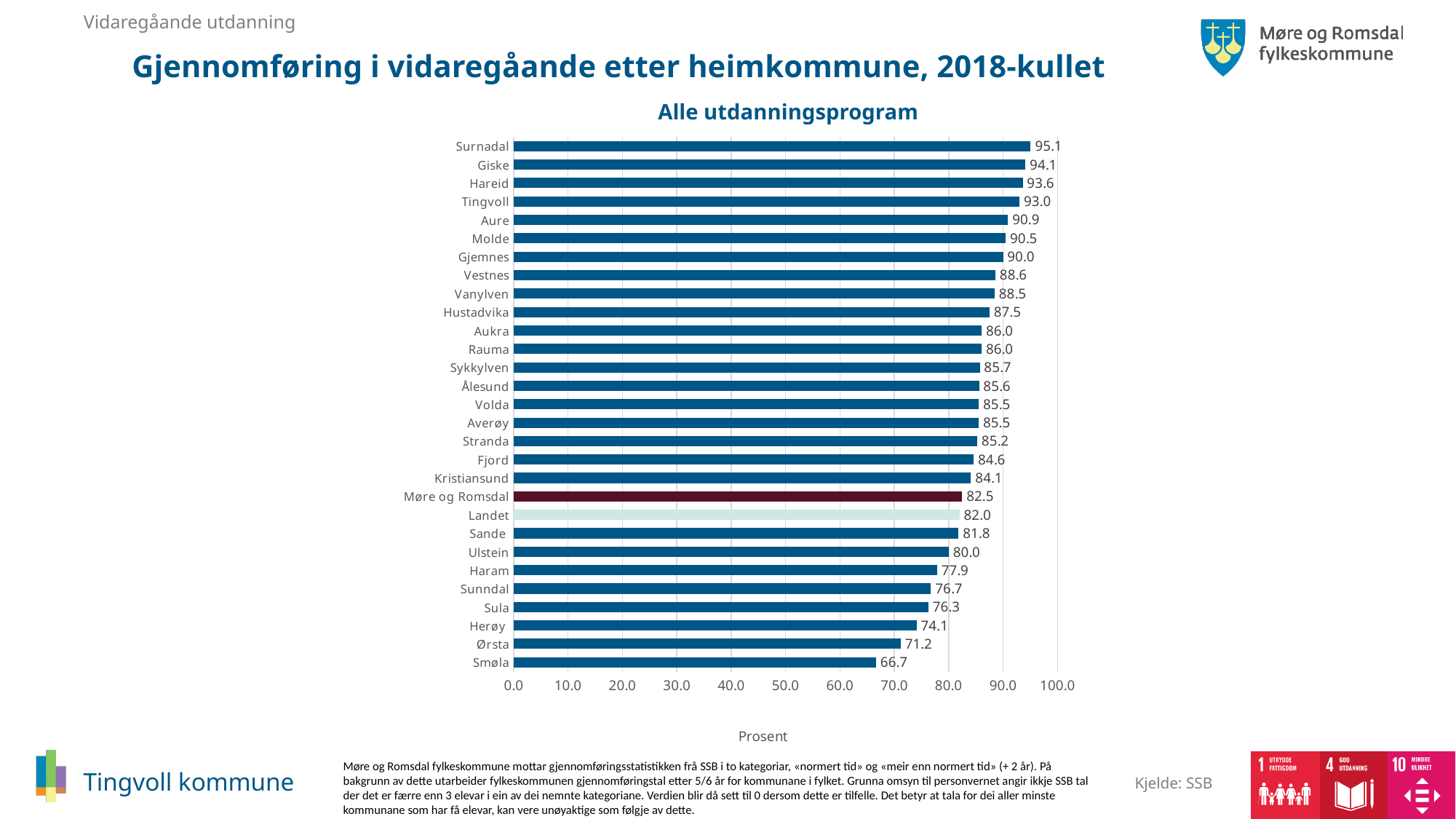
How many categories are shown in the chart? 29 What is the difference between the values for Surnadal and Smøla? 28.4 Which category has the highest value? Surnadal Which category has the lowest value? Smøla What is the value for Møre og Romsdal? 82.5 What kind of chart is shown on the slide? Bar chart Which has a larger value, Molde or Ålesund? Molde What is the value for Landet? 82.0 What is the title of the chart? Alle utdanningsprogram What is the difference between the values for Tingvoll and Landet? 11.0 Is the value for Ørsta greater or less than 80.0? less What is the value for Tingvoll? 93.0